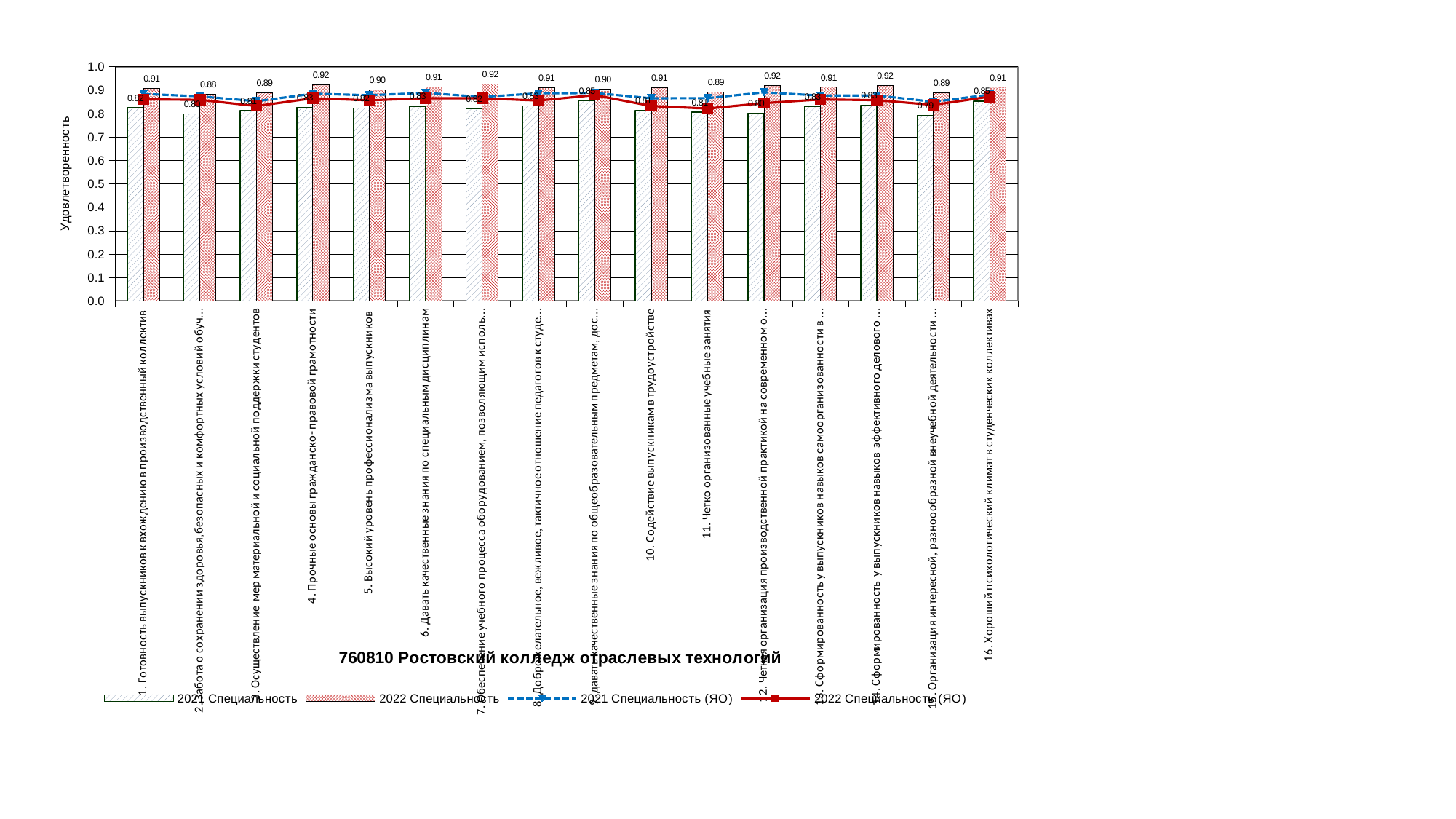
What is the difference between the 2022 Специальность values for "4. Прочные основы гражданско-правовой грамотности" and "11. Четко организованные учебные занятия"? 0.03 How many series does the legend list? 4 Which has the higher 2022 Специальность value: "4. Прочные основы гражданско-правовой грамотности" or "11. Четко организованные учебные занятия"? 4. Прочные основы гражданско-правовой грамотности How many categories are shown on the x axis? 16 Is the 2021 Специальность value for "1. Готовность выпускников к вхождению в производственный коллектив" greater or less than 0.9? less What kind of chart is this? A bar chart combined with line series What is the title of the chart? 760810 Ростовский колледж отраслевых технологий What is the 2022 Специальность value for "4. Прочные основы гражданско-правовой грамотности"? 0.92 What is the 2022 Специальность value for "16. Хороший психологический климат в студенческих коллективах"? 0.91 What is the 2022 Специальность value for "1. Готовность выпускников к вхождению в производственный коллектив"? 0.91 What is the 2022 Специальность value for "5. Высокий уровень профессионализма выпускников"? 0.90 What is the 2022 Специальность value for "11. Четко организованные учебные занятия"? 0.89